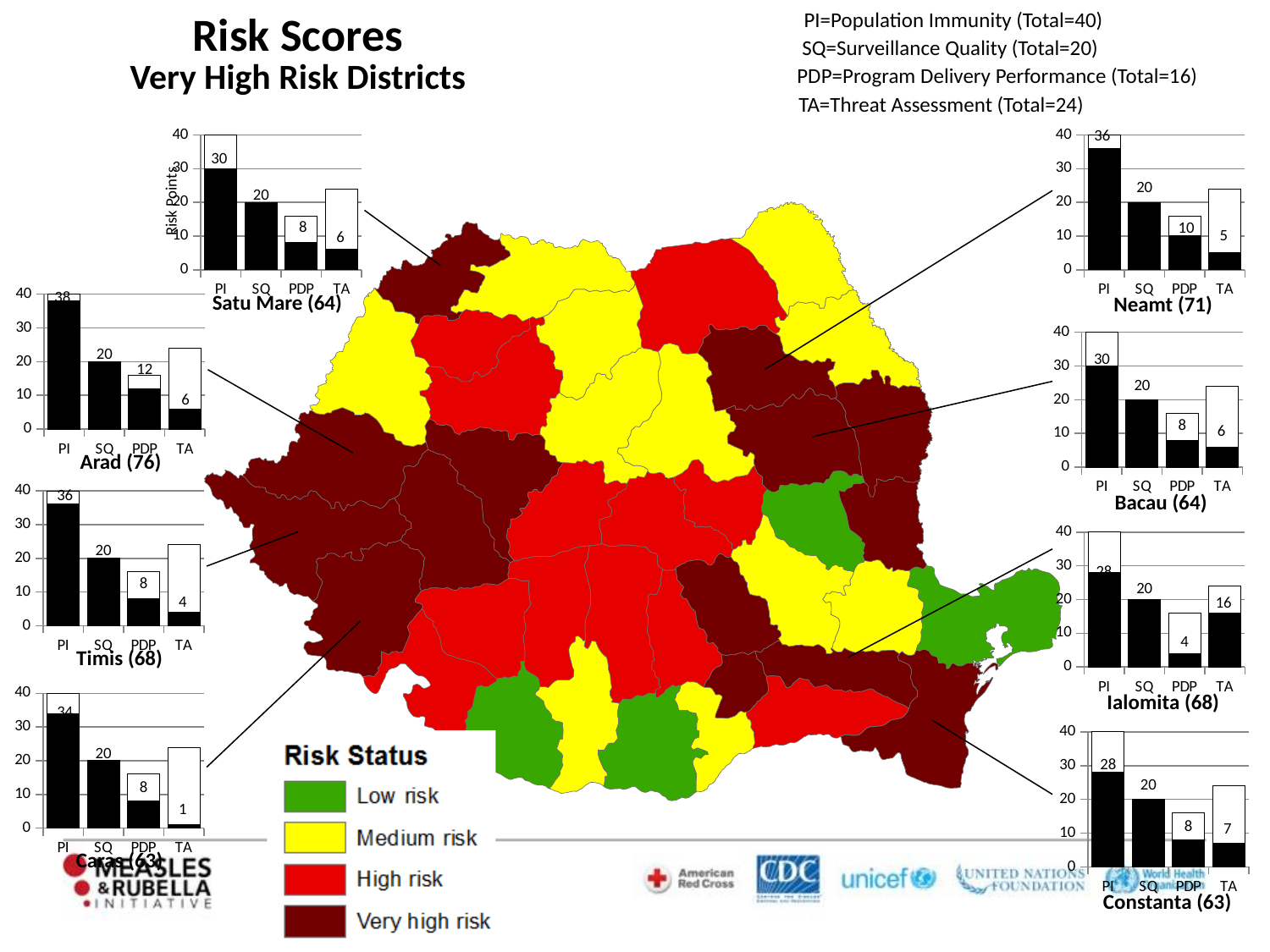
In the Constanta (63) chart, which is larger, the PDP value or the TA value? PDP What type of chart is the Neamt (71) chart? Bar chart In the Satu Mare (64) chart, what is the difference between the PI value and the SQ value? 10 How many categories does the Bacau (64) chart show? 4 In the Neamt (71) chart, what is the value for PDP? 10 What is the axis title on the vertical axis of the Satu Mare (64) chart? Risk Points In the Arad (76) chart, do the values rise or fall from PI to TA along the x axis? Fall In the Arad (76) chart, what is the value for PI? 38 In the Timis (68) chart, which category has the highest value? PI In the Ialomita (68) chart, what is the value for TA? 16 In the Ialomita (68) chart, which category has the lowest value? PDP In the Caras (63) chart, what is the value for TA? 1